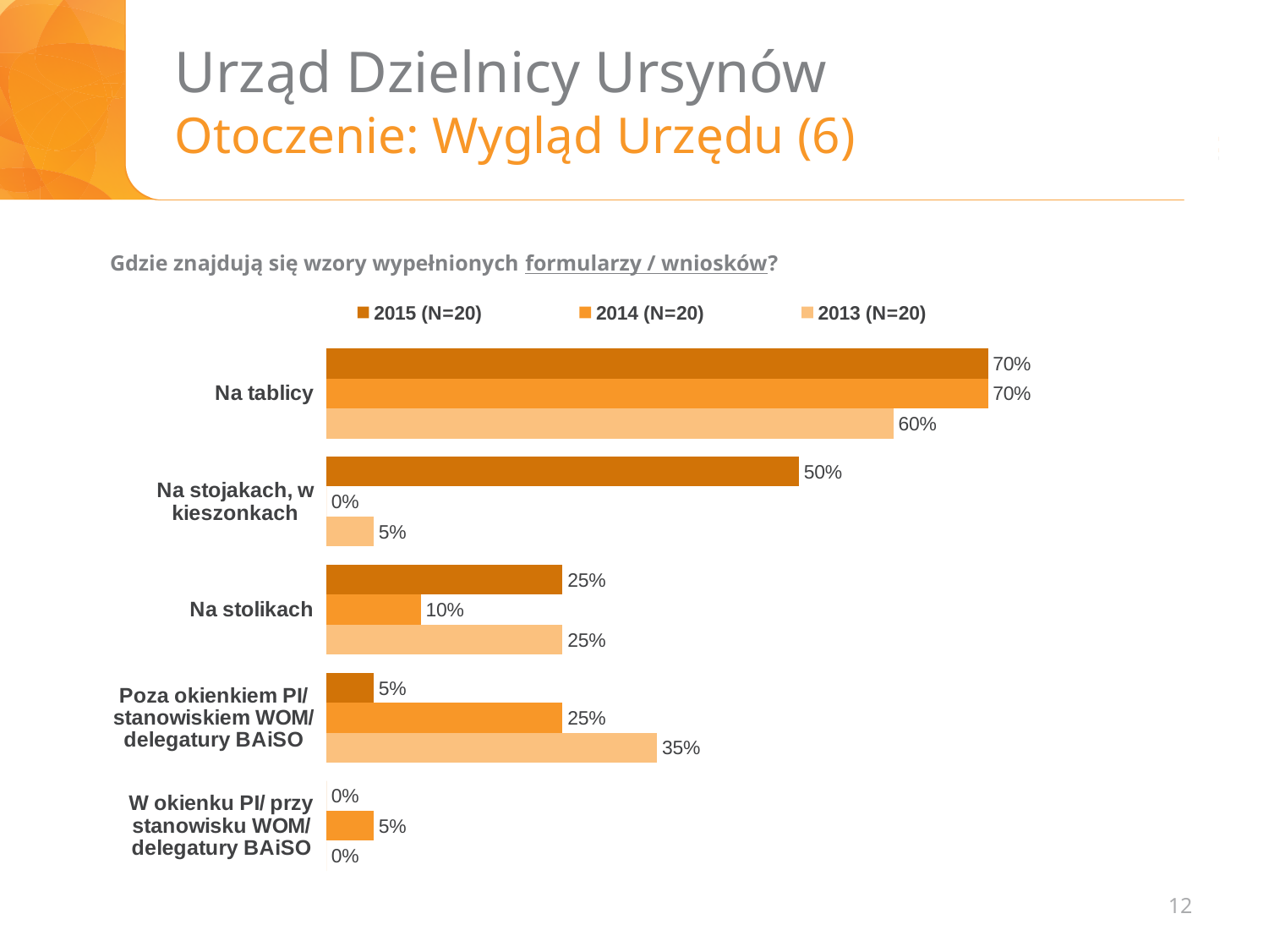
What kind of chart is shown on the slide? Bar chart How many series does the legend list? 3 Which category has the lowest value in the 2013 (N=20) series? W okienku PI/ przy stanowisku WOM/ delegatury BAiSO What is the value for "Na stojakach, w kieszonkach" in the 2014 (N=20) series? 0% What is the value for "Poza okienkiem PI/ stanowiskiem WOM/ delegatury BAiSO" in the 2013 (N=20) series? 35% What is the difference between the 2015 (N=20) and 2013 (N=20) values for "Na stojakach, w kieszonkach"? 45% Which category has the highest value in the 2015 (N=20) series? Na tablicy For "Poza okienkiem PI/ stanowiskiem WOM/ delegatury BAiSO", which series has the larger value: 2015 (N=20) or 2014 (N=20)? 2014 (N=20) What is the value for "Na tablicy" in the 2015 (N=20) series? 70% How many categories are shown on the chart? 5 What question is the chart about, as stated above it? Gdzie znajdują się wzory wypełnionych formularzy / wniosków? What is the value for "Na stolikach" in the 2014 (N=20) series? 10%